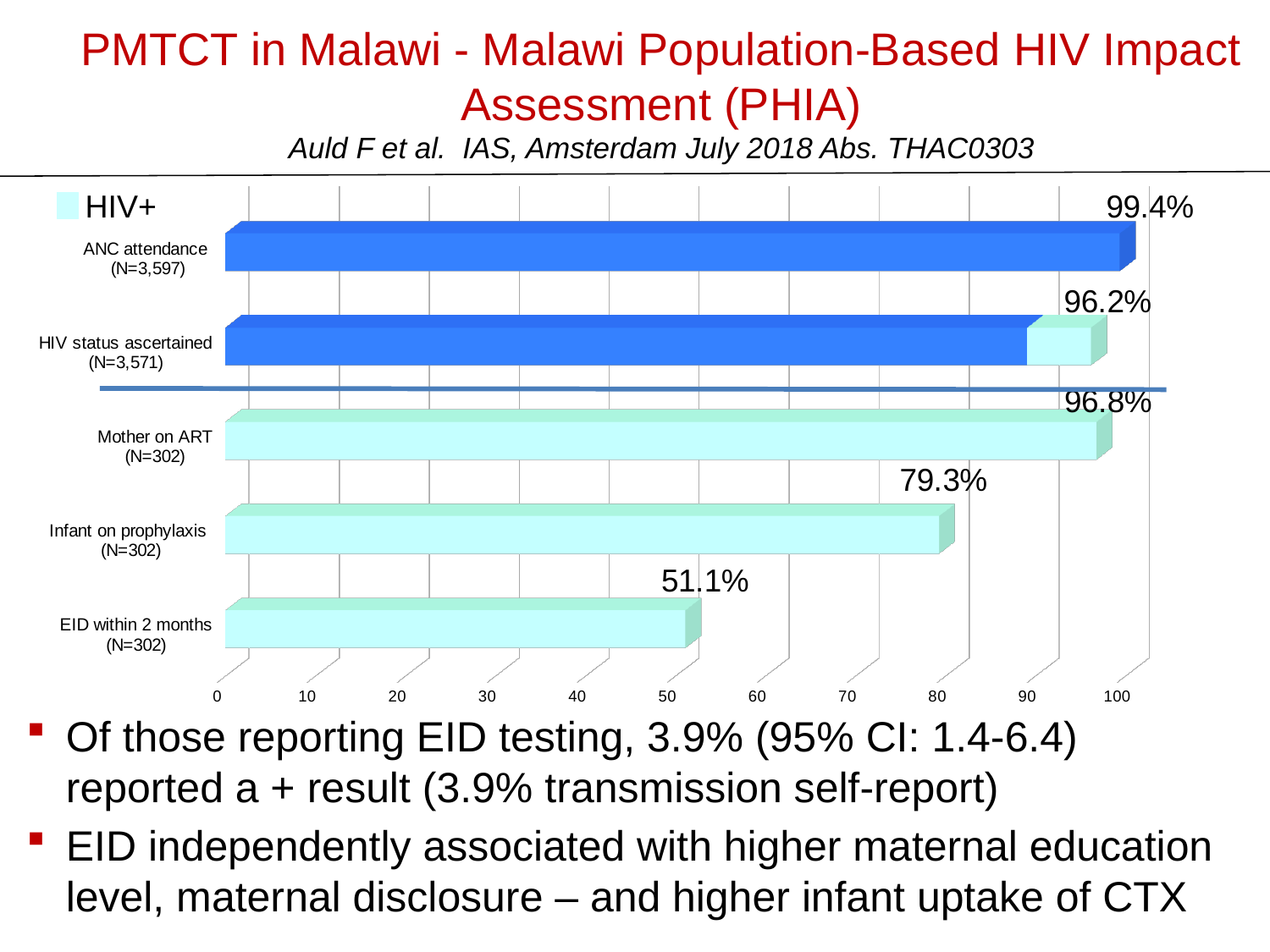
Is the value for Infant on prophylaxis greater or less than 70? greater What is the difference between the values for ANC attendance and EID within 2 months? 48.3 percentage points What is the value for Mother on ART (N=302)? 96.8% Which category has the lowest value? EID within 2 months (N=302) Which is larger, the value for Infant on prophylaxis or the value for EID within 2 months? Infant on prophylaxis What is the value for EID within 2 months (N=302)? 51.1% Which category has the highest value? ANC attendance (N=3,597) What kind of chart is shown on the slide? Bar chart What is the value for Infant on prophylaxis (N=302)? 79.3% How many categories are shown on the chart? 5 What is the difference between the values for Mother on ART and Infant on prophylaxis? 17.5 percentage points What is the value for ANC attendance (N=3,597)? 99.4%